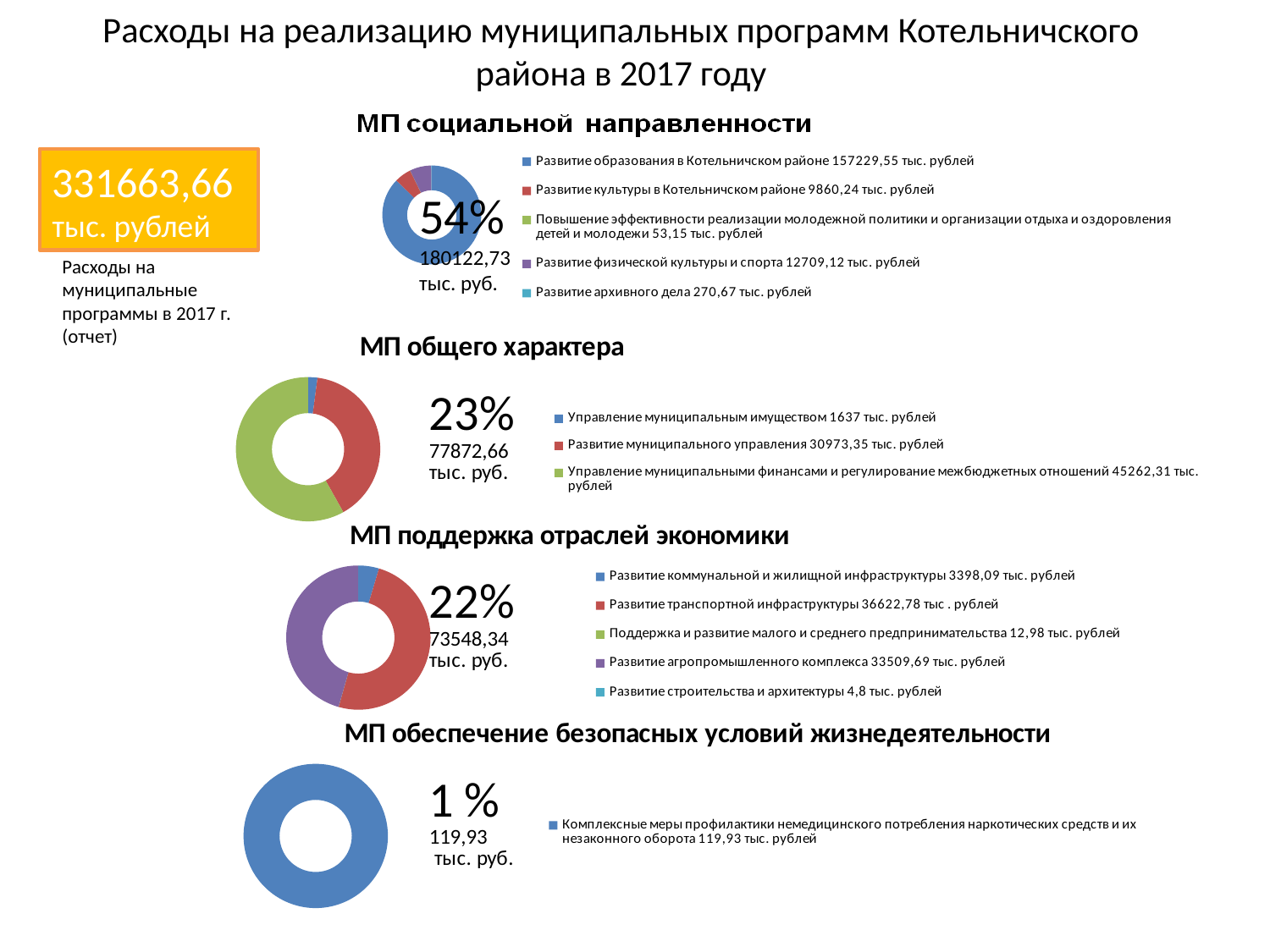
In the chart titled "МП поддержка отраслей экономики", which category has the lowest value? Развитие строительства и архитектуры In the chart titled "МП поддержка отраслей экономики", what is the value for "Развитие агропромышленного комплекса"? 33509,69 тыс. рублей What kind of chart is used for "МП обеспечение безопасных условий жизнедеятельности"? Doughnut chart In the chart titled "МП общего характера", what is the value for "Развитие муниципального управления"? 30973,35 тыс. рублей In the chart titled "МП общего характера", which is larger: "Управление муниципальными финансами и регулирование межбюджетных отношений" or "Развитие муниципального управления"? Управление муниципальными финансами и регулирование межбюджетных отношений In the chart titled "МП социальной направленности", what is the value for "Развитие культуры в Котельничском районе"? 9860,24 тыс. рублей In the chart titled "МП поддержка отраслей экономики", what is the difference between "Развитие транспортной инфраструктуры" and "Развитие агропромышленного комплекса"? 3113,09 тыс. рублей How many categories does the legend of the chart titled "МП социальной направленности" list? 5 What share of total expenditure does the chart titled "МП общего характера" show in its centre? 23% What total amount is shown in the centre of the chart titled "МП социальной направленности"? 180122,73 тыс. руб. In the chart titled "МП социальной направленности", which category has the highest value? Развитие образования в Котельничском районе In the chart titled "МП социальной направленности", which category has the lowest value? Повышение эффективности реализации молодежной политики и организации отдыха и оздоровления детей и молодежи